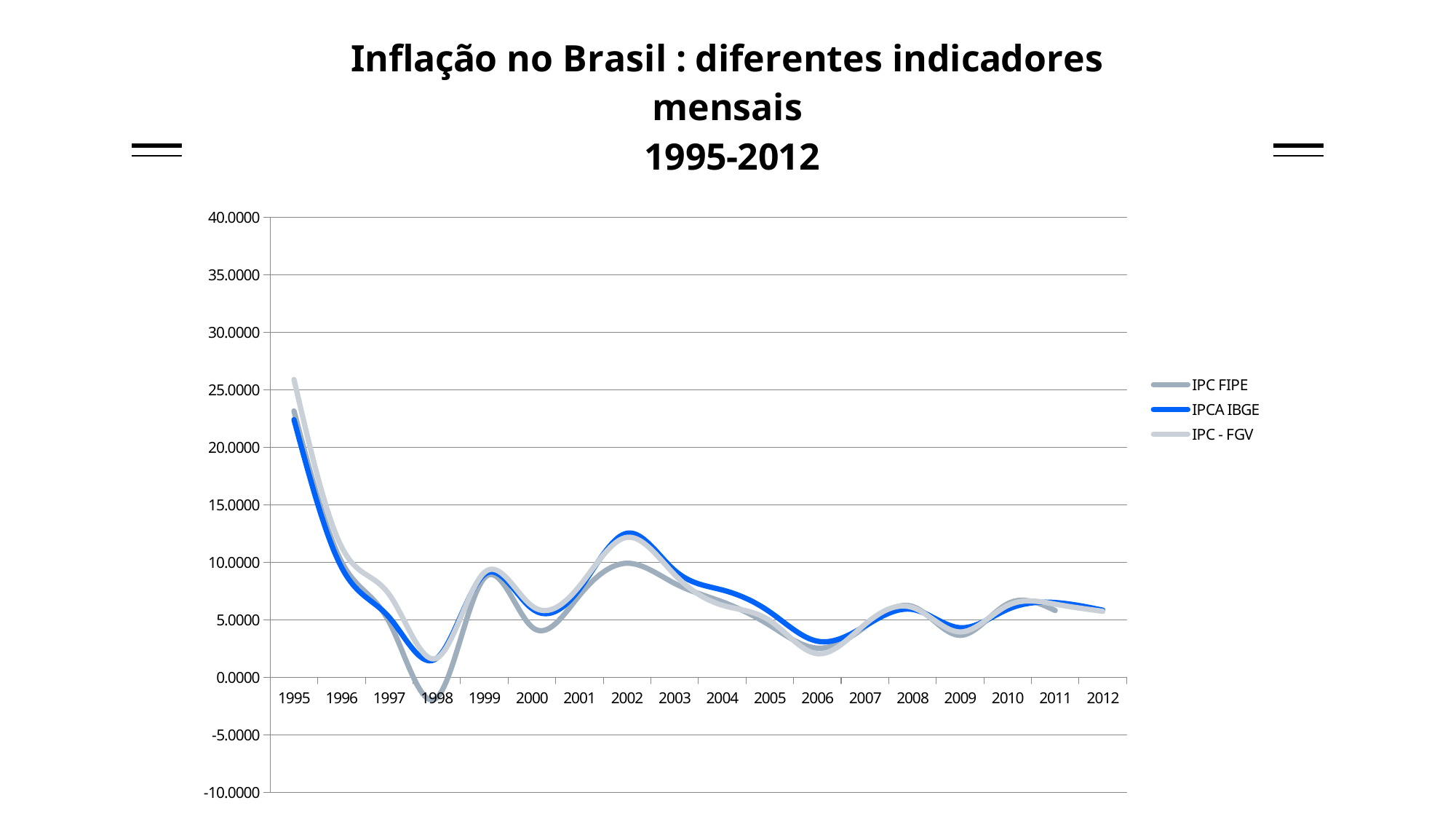
Is the value for IPCA IBGE in 2002 greater or less than 10.0000? greater Is the value for IPC FIPE in 1998 greater or less than 0.0000? less How many series does the legend list? 3 Is the value for IPC - FGV in 1995 greater or less than 25.0000? greater In which year is the IPCA IBGE series at its highest? 1995 What is the title of the chart? Inflação no Brasil : diferentes indicadores mensais 1995-2012 In which year is the IPC FIPE series at its lowest? 1998 How many years are shown along the x axis? 18 Which is larger in 1995, IPC - FGV or IPCA IBGE? IPC - FGV What kind of chart is shown on the slide? line chart Which series is drawn in blue? IPCA IBGE